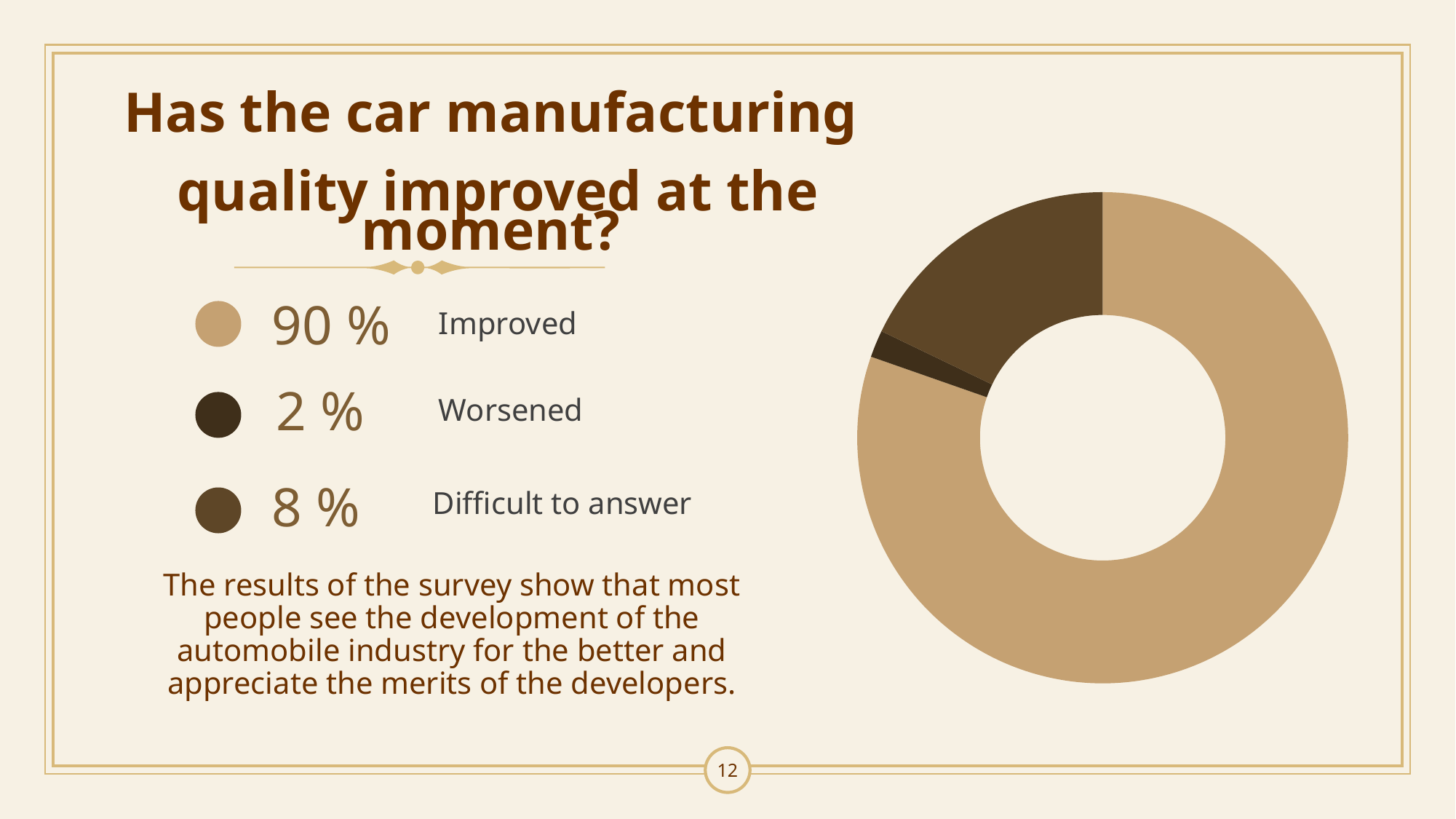
What share of respondents found it "Difficult to answer"? 8 % What is the difference in percentage points between "Improved" and "Difficult to answer"? 82 Which response has the smallest share of the chart? Worsened Which is larger, the share for "Worsened" or the share for "Difficult to answer"? Difficult to answer What is the total of the three percentages shown? 100 % Which colour represents the "Worsened" response in the chart? Dark brown (nearly black) Which response has the largest share of the chart? Improved What share of respondents answered "Worsened"? 2 % What share of respondents answered "Improved"? 90 % What is the difference in percentage points between "Difficult to answer" and "Worsened"? 6 What kind of chart is shown on the slide? Doughnut chart How many response categories are shown in the chart? 3